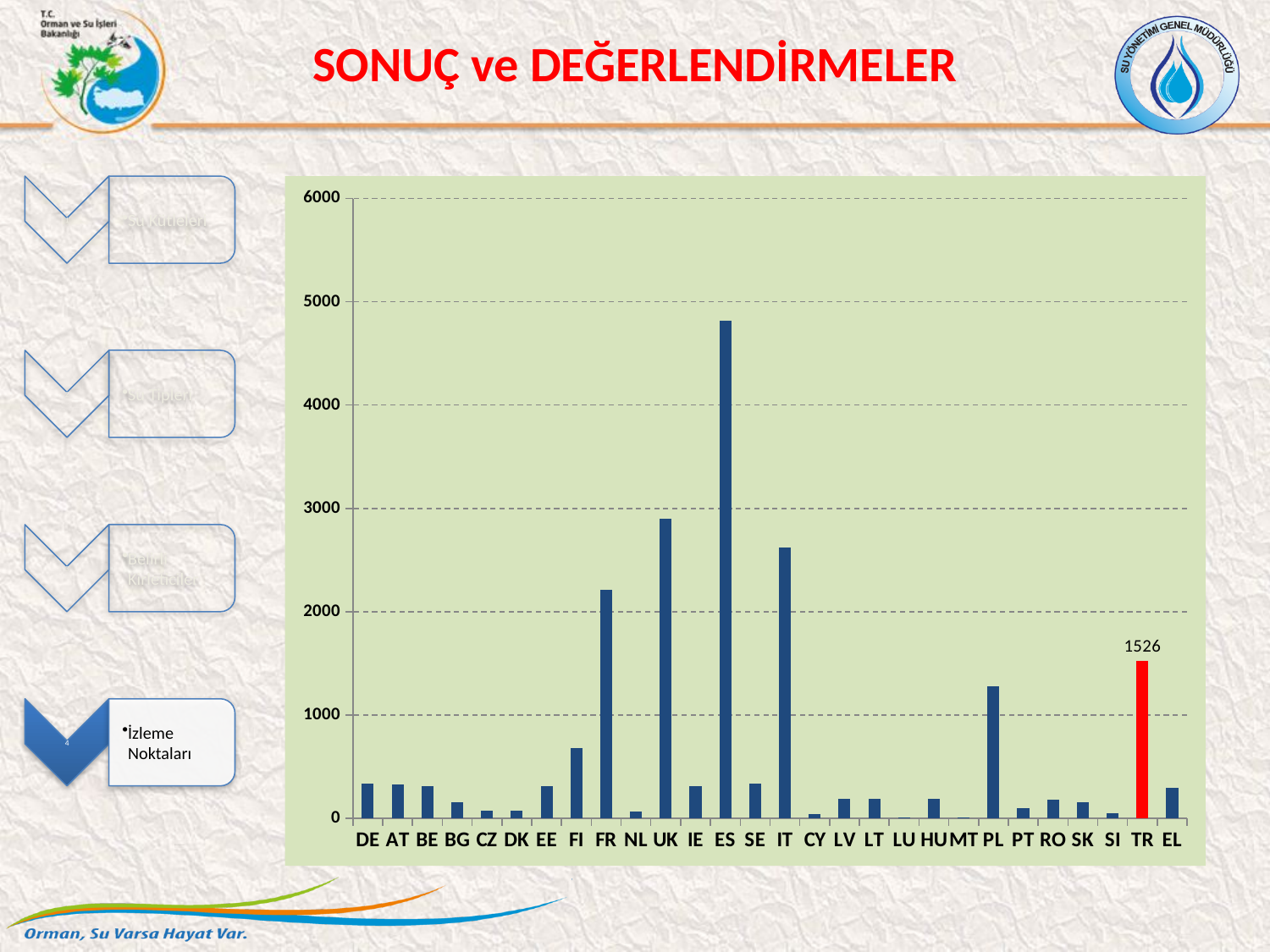
Is the value for ES greater or less than 4000? greater Which is larger, the value for ES or the value for UK? ES Is the value for UK greater or less than 3000? less Which is larger, the value for TR or the value for PL? TR Which is larger, the value for IT or the value for FR? IT What value is shown for TR in the bar chart? 1526 How many countries are shown on the x axis of the chart? 28 What kind of chart is shown on the slide? bar chart Is the value for FR greater or less than 2000? greater Which country has the highest bar in the chart? ES